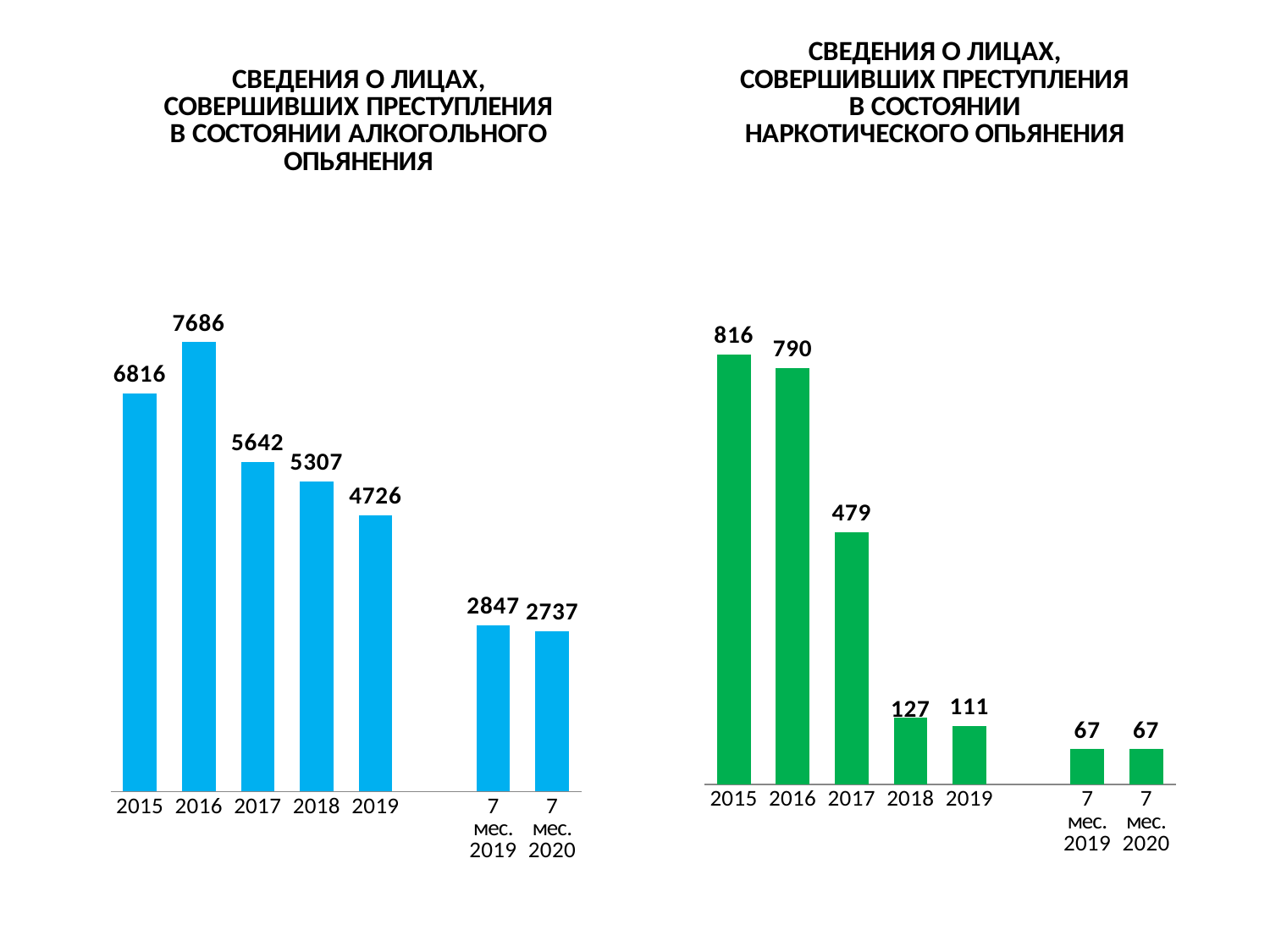
What type of chart is the left chart (alcohol intoxication)? bar chart How many bars are shown in the right chart (drug intoxication)? 7 In the left chart (alcohol intoxication), what is the value for 2016? 7686 In the left chart (alcohol intoxication), which year from 2015 to 2019 has the highest value? 2016 In the right chart (drug intoxication), what is the value for 2017? 479 In the left chart (alcohol intoxication), what is the difference between the 2015 and 2019 values? 2090 In the right chart (drug intoxication), what is the value for 7 мес. 2019? 67 In the right chart (drug intoxication), which is larger, the value for 2018 or the value for 2019? 2018 In the left chart (alcohol intoxication), what is the value for 7 мес. 2020? 2737 In the left chart (alcohol intoxication), do the values rise or fall from 2016 to 2019? fall In the right chart (drug intoxication), which category has the lowest value among the years 2015 to 2019? 2019 In the right chart (drug intoxication), what is the difference between the 2015 and 2016 values? 26